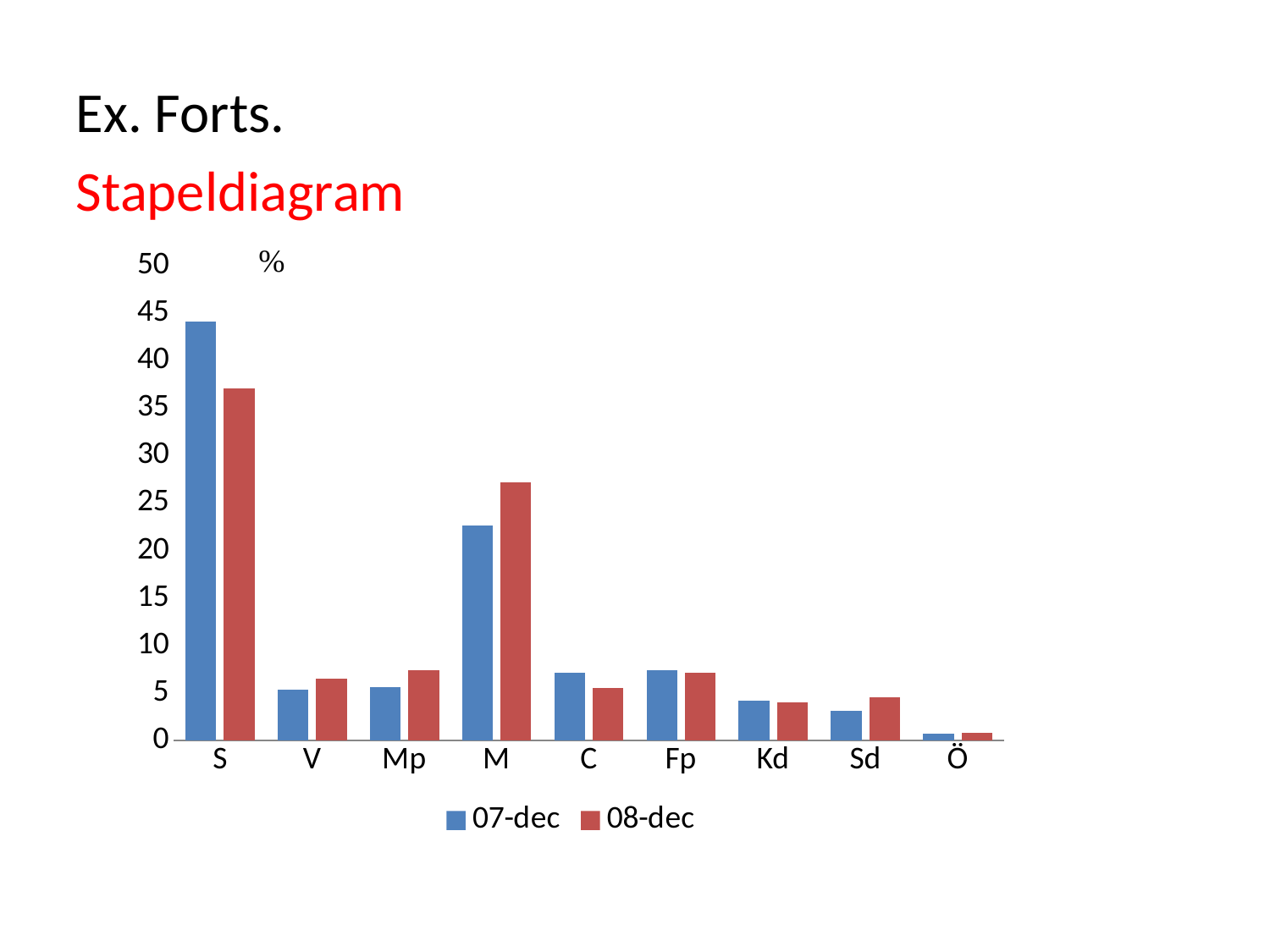
Is the 07-dec value for M greater or less than 25? less Which category has the highest value for the 07-dec series? S For category S, which series has the larger value, 07-dec or 08-dec? 07-dec Is the 07-dec value for S greater or less than 40? greater For category M, which series has the larger value, 07-dec or 08-dec? 08-dec How many categories are shown on the x axis? 9 Which category has the lowest value for the 08-dec series? Ö How many series does the legend list? 2 Is the 08-dec value for M greater or less than 25? greater What kind of chart is shown on the slide? bar chart What are the two series names listed in the legend? 07-dec and 08-dec